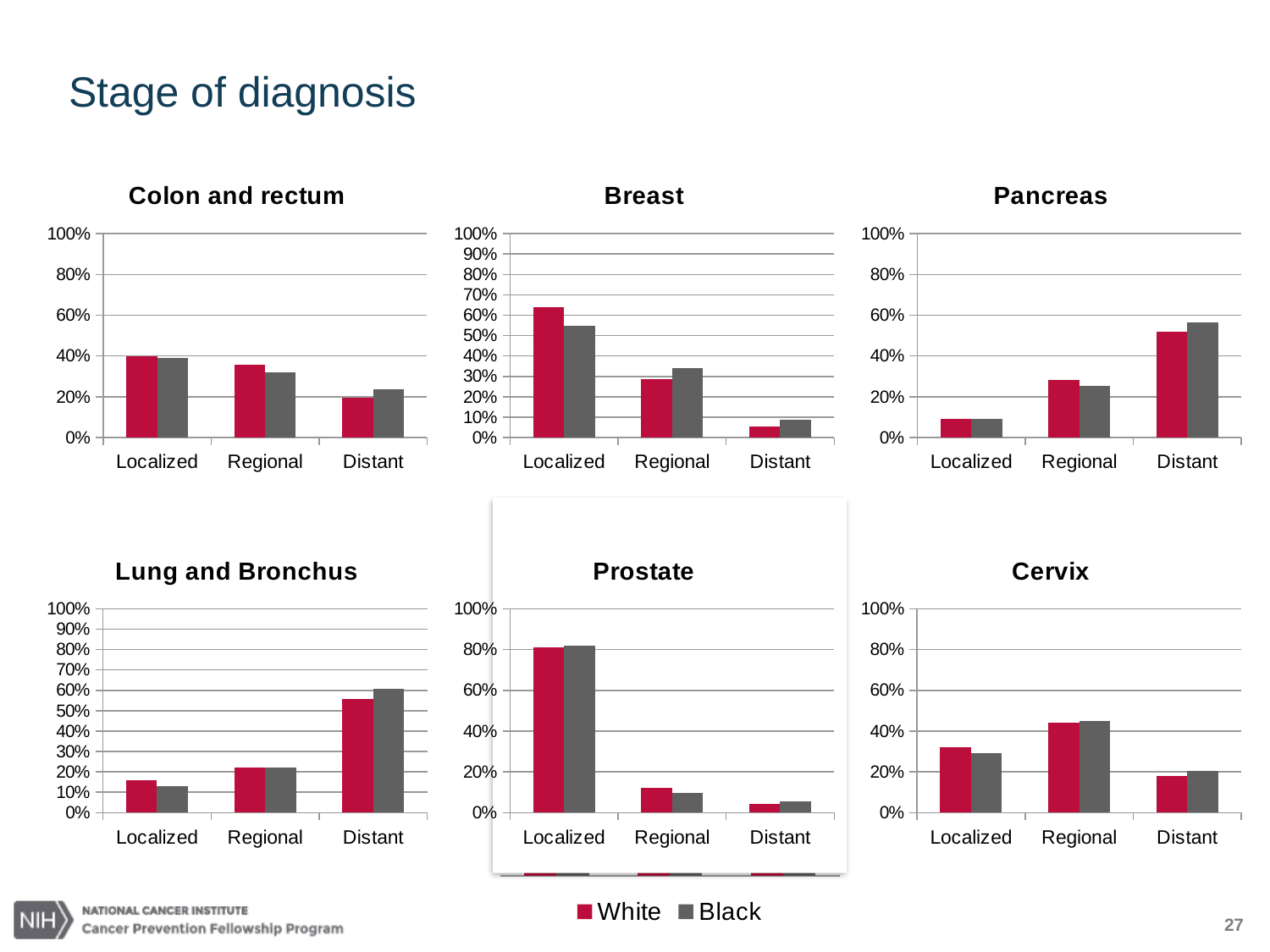
How many series does the legend at the bottom of the slide list? 2 In the Cervix chart, which stage has the lowest value for White? Distant In the Colon and rectum chart, is the Distant value for White greater or less than 40%? less In the Prostate chart, is the Localized value for White greater or less than 60%? greater In the Lung and Bronchus chart, which is larger for the Distant stage, White or Black? Black In the Pancreas chart, which stage has the highest value for Black? Distant In the Breast chart, how many stage categories are shown on the x axis? 3 In the Pancreas chart, do the White values rise or fall from Localized to Distant? rise In the Breast chart, is the Localized value for White greater or less than 60%? greater In the Breast chart, which is larger for the Regional stage, White or Black? Black What kind of chart is the Prostate chart? bar chart In the Breast chart, which stage has the highest value for White? Localized